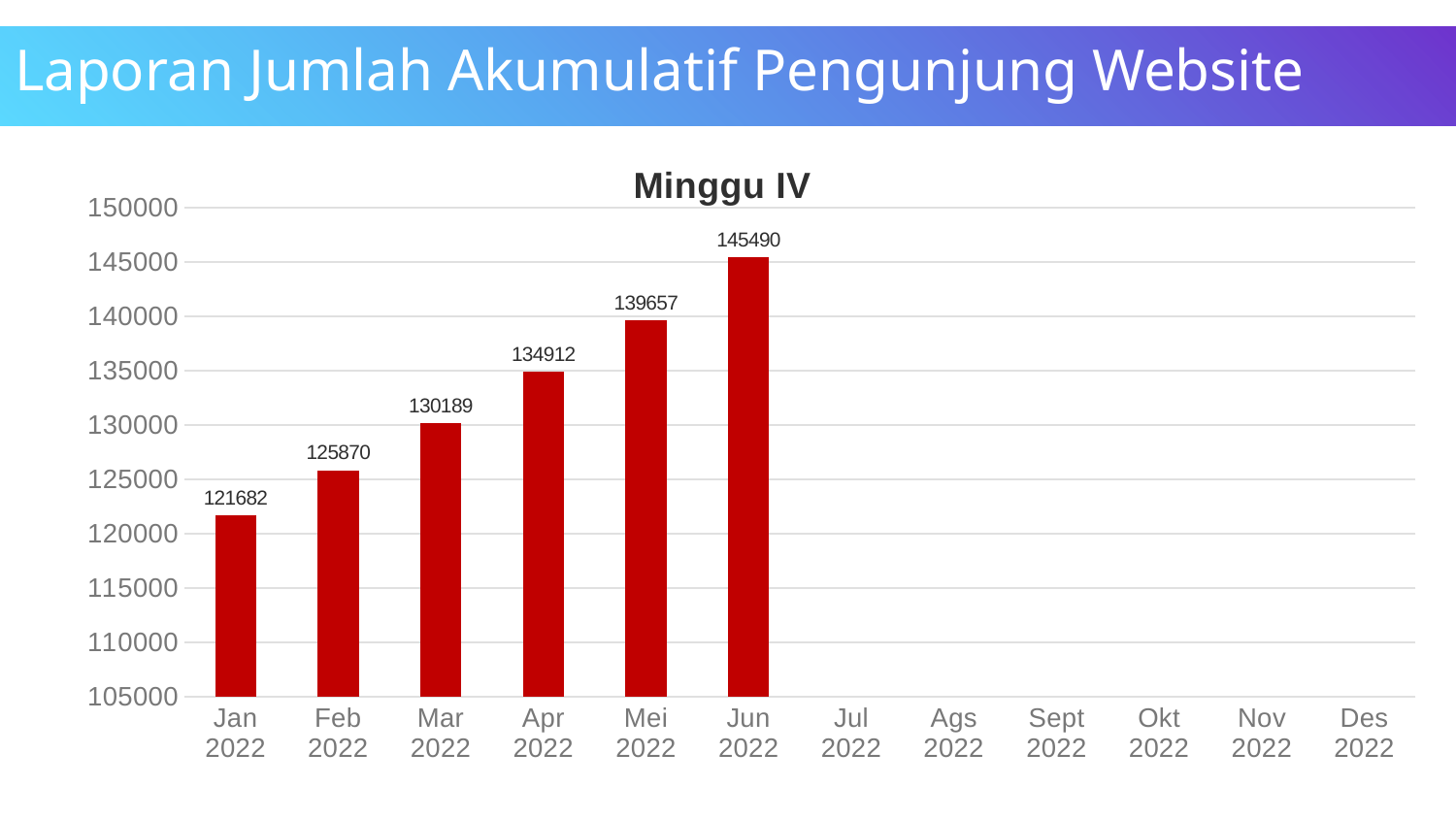
What is the value for Jan 2022? 121682 What is the value for Jun 2022? 145490 Which month has the highest value? Jun 2022 Do the values rise or fall from Jan 2022 to Jun 2022? rise How many months have a bar plotted? 6 Which month with a plotted bar has the lowest value? Jan 2022 Which is larger, the value for Mar 2022 or the value for Mei 2022? Mei 2022 What is the difference between the values for Jun 2022 and Mei 2022? 5833 What kind of chart is shown? bar chart Is the value for Apr 2022 greater or less than 130000? greater What is the difference between the values for Mar 2022 and Feb 2022? 4319 What is the value for Apr 2022? 134912